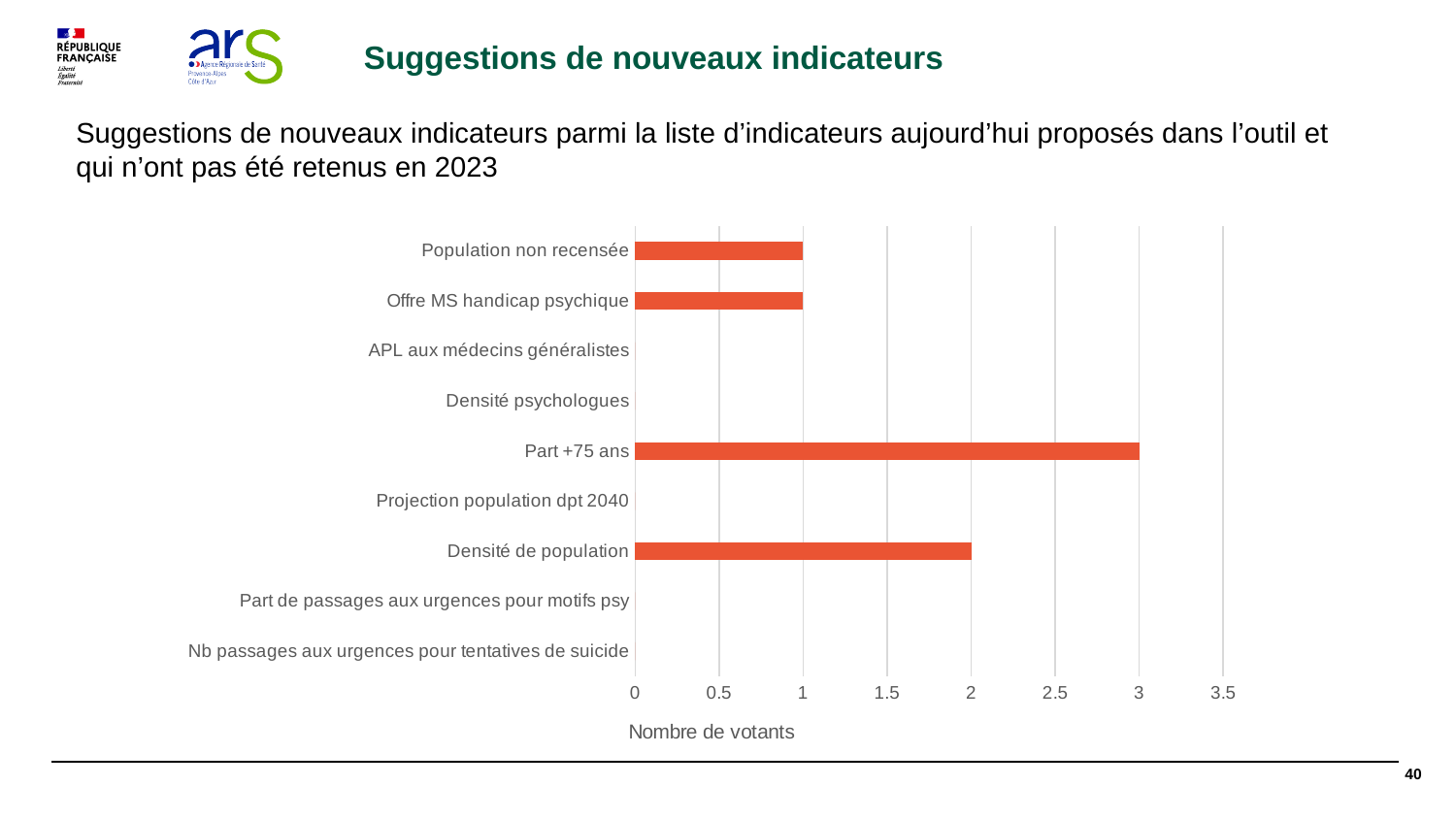
What kind of chart is shown on the slide? bar chart Which category has the highest number of votes (Nombre de votants)? Part +75 ans What is the title of the horizontal axis? Nombre de votants What is the value for Offre MS handicap psychique? 1 Which is larger, the value for Densité de population or the value for Offre MS handicap psychique? Densité de population How many categories are listed on the vertical axis of the chart? 9 What is the value for Part +75 ans? 3 What is the value for Population non recensée? 1 How many categories have no bar drawn at all? 5 What is the value for Densité de population? 2 Is the value for Part +75 ans greater or less than 2.5? greater What is the difference between the values for Part +75 ans and Densité de population? 1